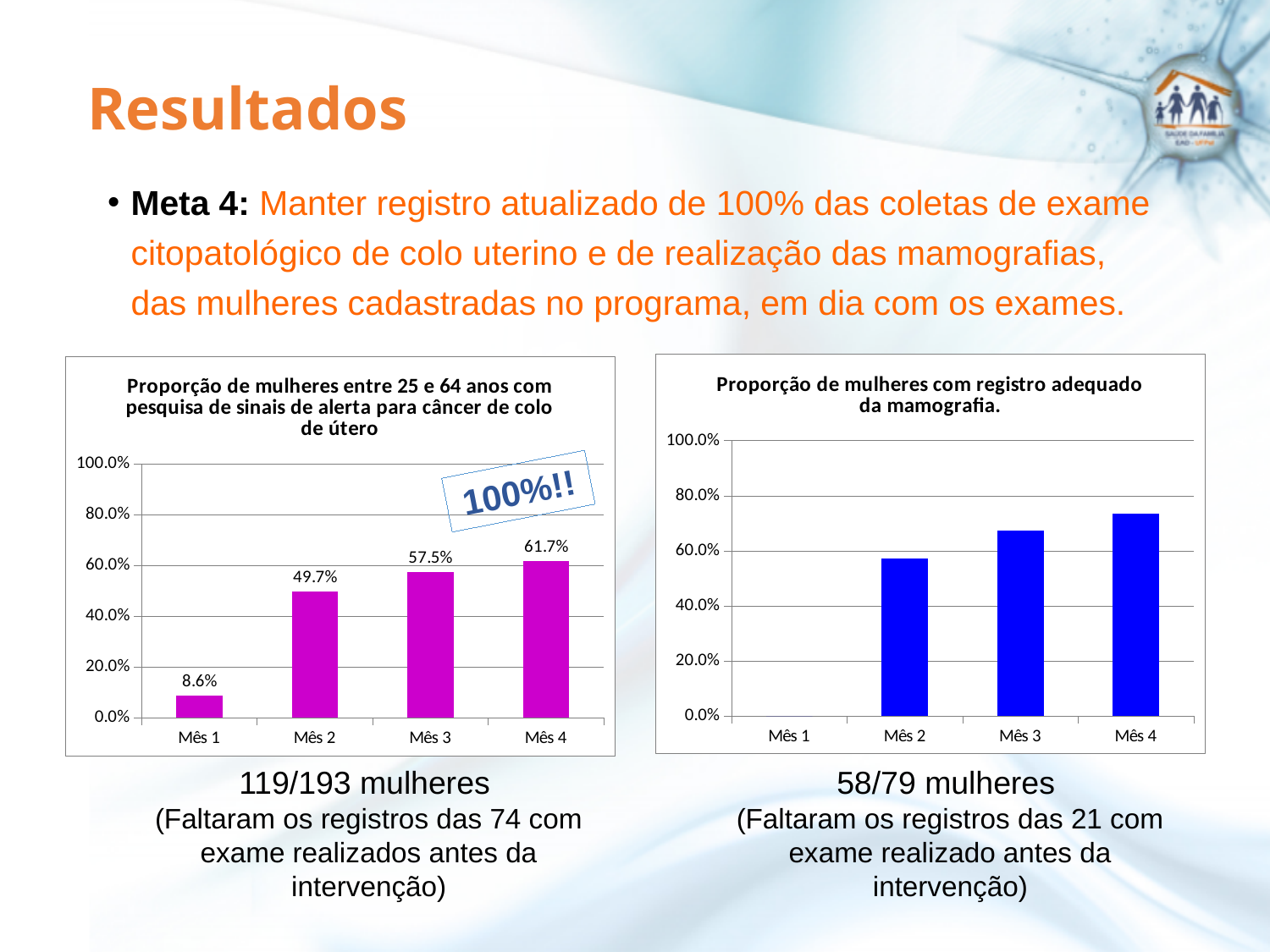
In the left chart (Proporção de mulheres entre 25 e 64 anos...), do the values rise or fall from Mês 1 to Mês 4? rise In the right chart (Proporção de mulheres com registro adequado da mamografia), is the value for Mês 2 greater or less than 60.0%? less In the left chart (Proporção de mulheres entre 25 e 64 anos...), what is the value for Mês 3? 57.5% What colour are the bars in the right chart (Proporção de mulheres com registro adequado da mamografia)? blue In the left chart (Proporção de mulheres entre 25 e 64 anos...), what is the value for Mês 1? 8.6% In the left chart (Proporção de mulheres entre 25 e 64 anos...), which month has the highest value? Mês 4 In the left chart (Proporção de mulheres entre 25 e 64 anos...), what is the difference between Mês 4 and Mês 2? 12.0% In the right chart (Proporção de mulheres com registro adequado da mamografia), is the value for Mês 4 greater or less than 60.0%? greater How many months are shown in the left chart (Proporção de mulheres entre 25 e 64 anos...)? 4 What type of chart is the right chart (Proporção de mulheres com registro adequado da mamografia)? bar chart In the right chart (Proporção de mulheres com registro adequado da mamografia), which is larger, Mês 3 or Mês 4? Mês 4 In the left chart (Proporção de mulheres entre 25 e 64 anos...), which month has the lowest value? Mês 1